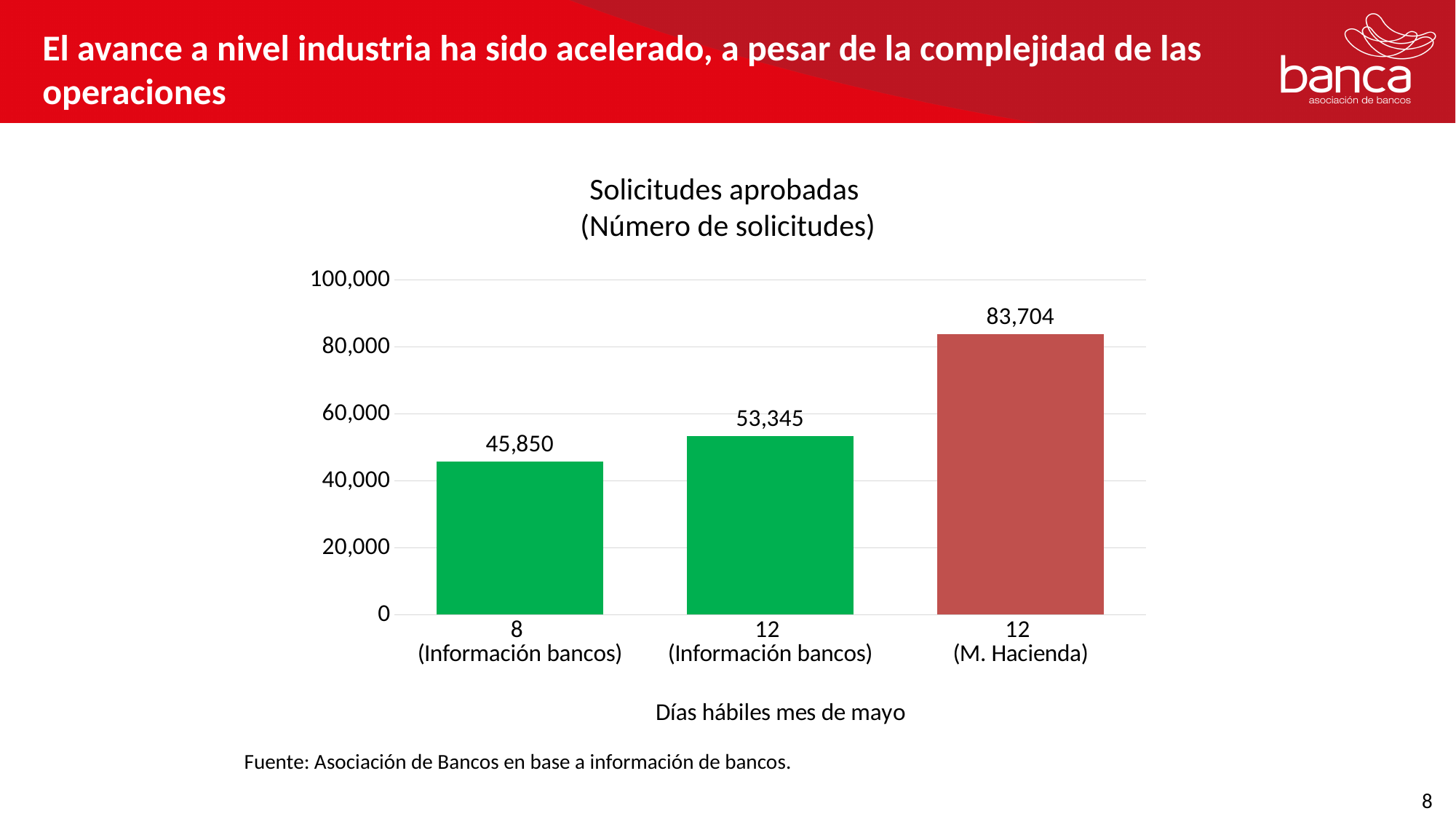
How many bars are shown in the chart? 3 What kind of chart is shown on the slide? Bar chart What is the difference between the values for "12 (Información bancos)" and "8 (Información bancos)"? 7,495 What is the value for "12 (Información bancos)"? 53,345 Which category has the highest value? 12 (M. Hacienda) What is the title of the chart? Solicitudes aprobadas (Número de solicitudes) Is the value for "12 (M. Hacienda)" greater or less than 80,000? greater Which category has the lowest value? 8 (Información bancos) What is the difference between the values for "12 (M. Hacienda)" and "12 (Información bancos)"? 30,359 Which is larger, the value for "12 (Información bancos)" or the value for "8 (Información bancos)"? 12 (Información bancos) What is the value for "12 (M. Hacienda)"? 83,704 What is the value for "8 (Información bancos)"? 45,850